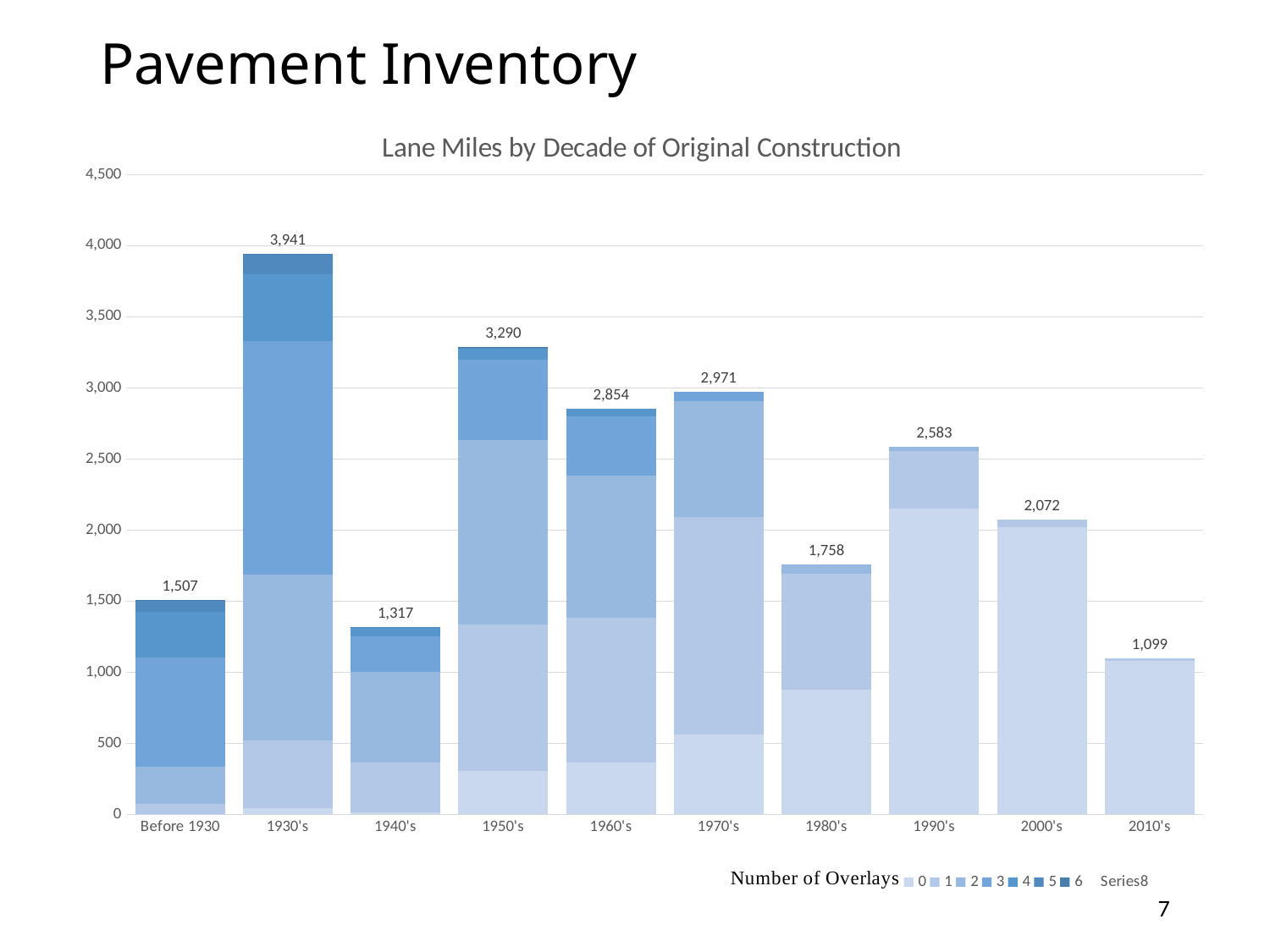
How many decade categories are shown on the x axis? 10 What is the difference between the total for the 1930's and the total for the 2010's? 2,842 What kind of chart is shown on the slide? Stacked bar chart What is the total lane miles labeled for the 1930's bar? 3,941 Which decade has the highest total lane miles? 1930's How many series does the legend list? 8 What is the difference between the total for the 1970's and the total for the 1960's? 117 Is the total for the 1980's greater or less than 1,500? greater Which decade has the lowest total lane miles? 2010's What is the total lane miles labeled for the 2000's bar? 2,072 Which has a larger total, the 1950's or the 1990's? 1950's What is the title of the chart? Lane Miles by Decade of Original Construction